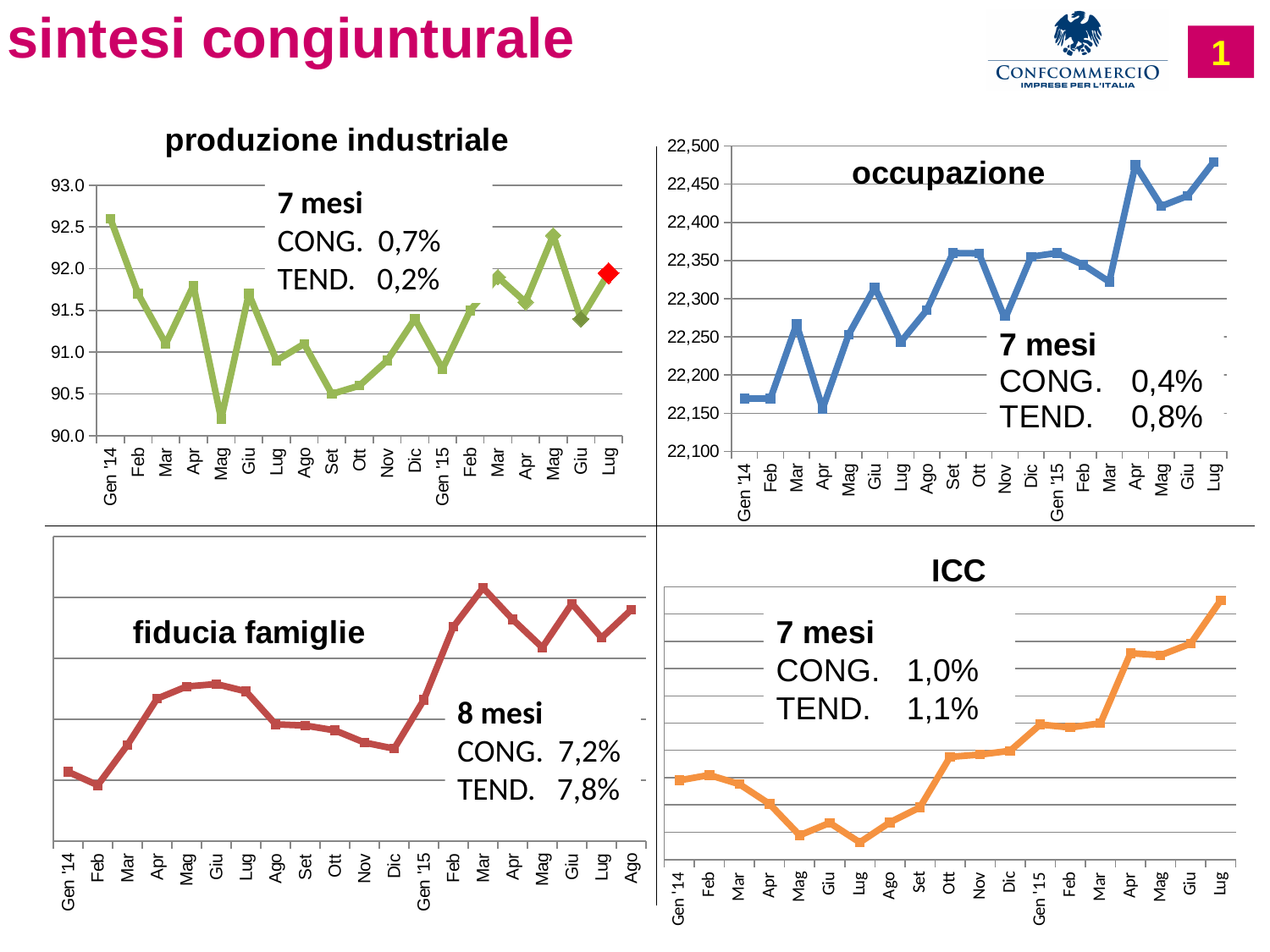
In the 'occupazione' chart, do values overall rise or fall from Gen '14 to Lug '15? rise How many monthly points are plotted in the 'fiducia famiglie' chart? 20 In the 'fiducia famiglie' chart, which month has the highest value? Mar (2015) In the 'produzione industriale' chart, is the value for Mag '14 greater or less than 90.5? less How many monthly points are plotted in the 'produzione industriale' chart? 19 In the 'produzione industriale' chart, is the value for Gen '14 greater or less than 92.0? greater What kind of chart is the 'produzione industriale' chart? line chart What CONG. value is printed on the 'ICC' chart? 1,0% In the 'ICC' chart, which month has the lowest value? Lug (2014) In the 'produzione industriale' chart, which month has the lowest value? Mag (2014) In the 'occupazione' chart, is the value for Lug '15 greater or less than 22,450? greater